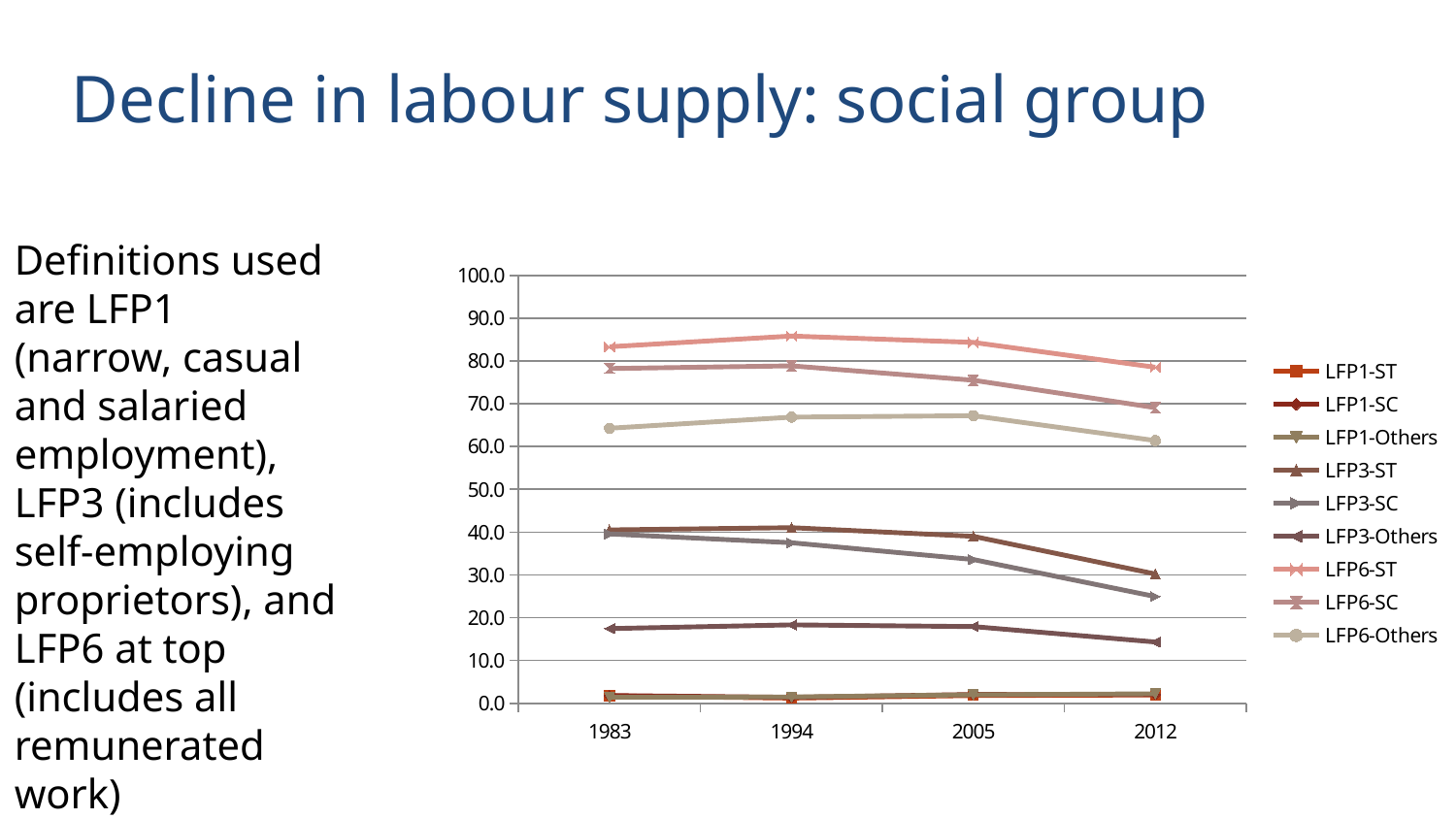
What is the title of the slide containing the chart? Decline in labour supply: social group Which series has the highest value in 2012? LFP6-ST Does the LFP3-SC series rise or fall from 1983 to 2012? fall In which year does LFP6-ST reach its highest value? 1994 Is the value for LFP3-Others in 2012 greater or less than 20.0? less Is the value for LFP6-ST in 1994 greater or less than 80.0? greater Is the value for LFP3-SC in 2012 greater or less than 30.0? less How many years are shown on the x axis? 4 In 2012, which is larger, LFP6-ST or LFP6-SC? LFP6-ST What kind of chart is shown on the slide? line chart How many series does the legend list? 9